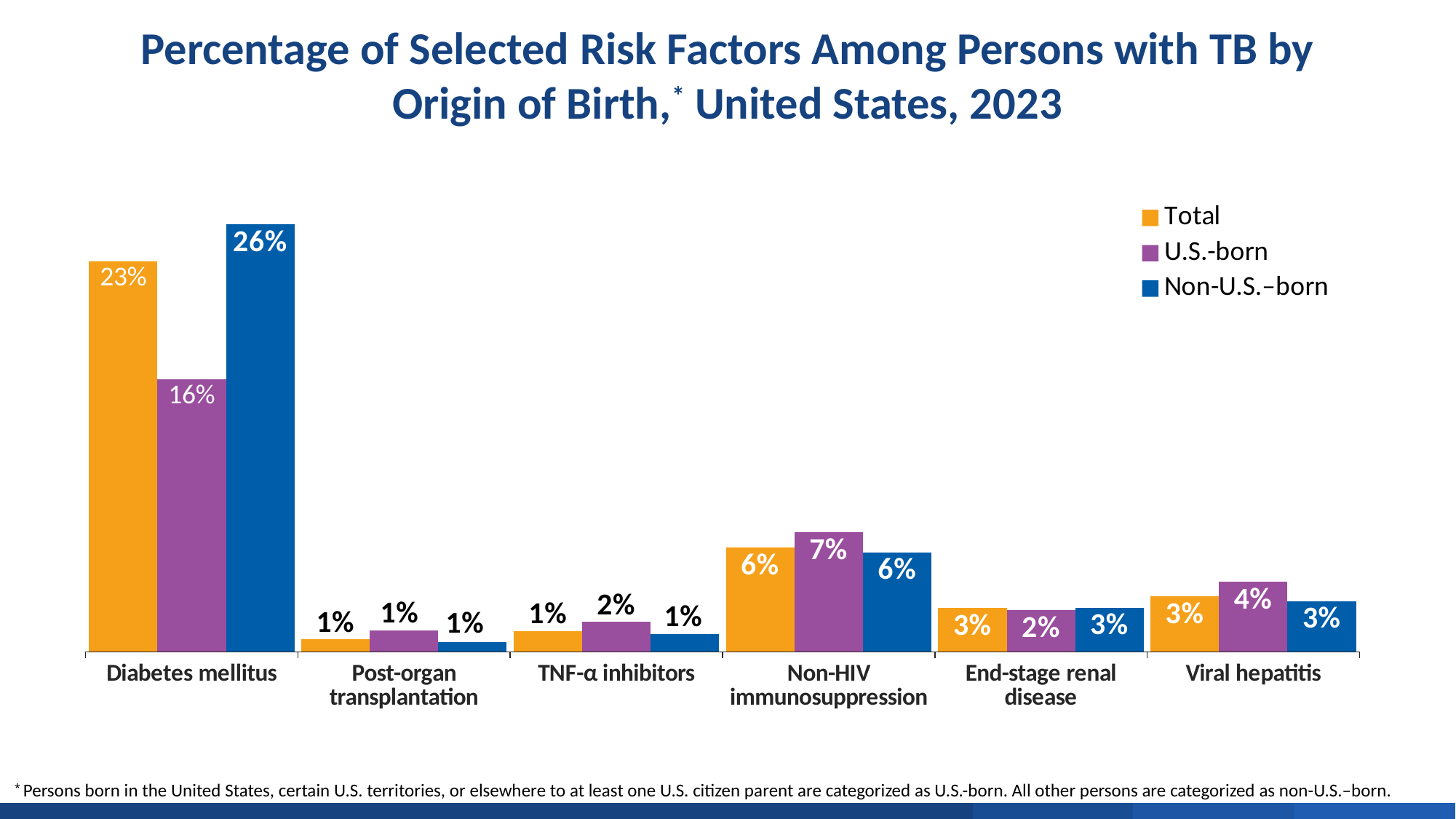
Which colour represents the U.S.-born series in the legend? Purple What is the difference between the Non-U.S.-born and U.S.-born percentages for Diabetes mellitus? 10% How many series does the legend list? 3 What is the Non-U.S.-born percentage for Diabetes mellitus? 26% What is the U.S.-born percentage for Non-HIV immunosuppression? 7% For Diabetes mellitus, which is larger: the Total percentage or the U.S.-born percentage? Total Which risk factor has the highest Total percentage? Diabetes mellitus What kind of chart is shown on the slide? Bar chart What is the Total percentage for Viral hepatitis? 3% What is the U.S.-born percentage for End-stage renal disease? 2% How many risk factor categories are shown on the x axis? 6